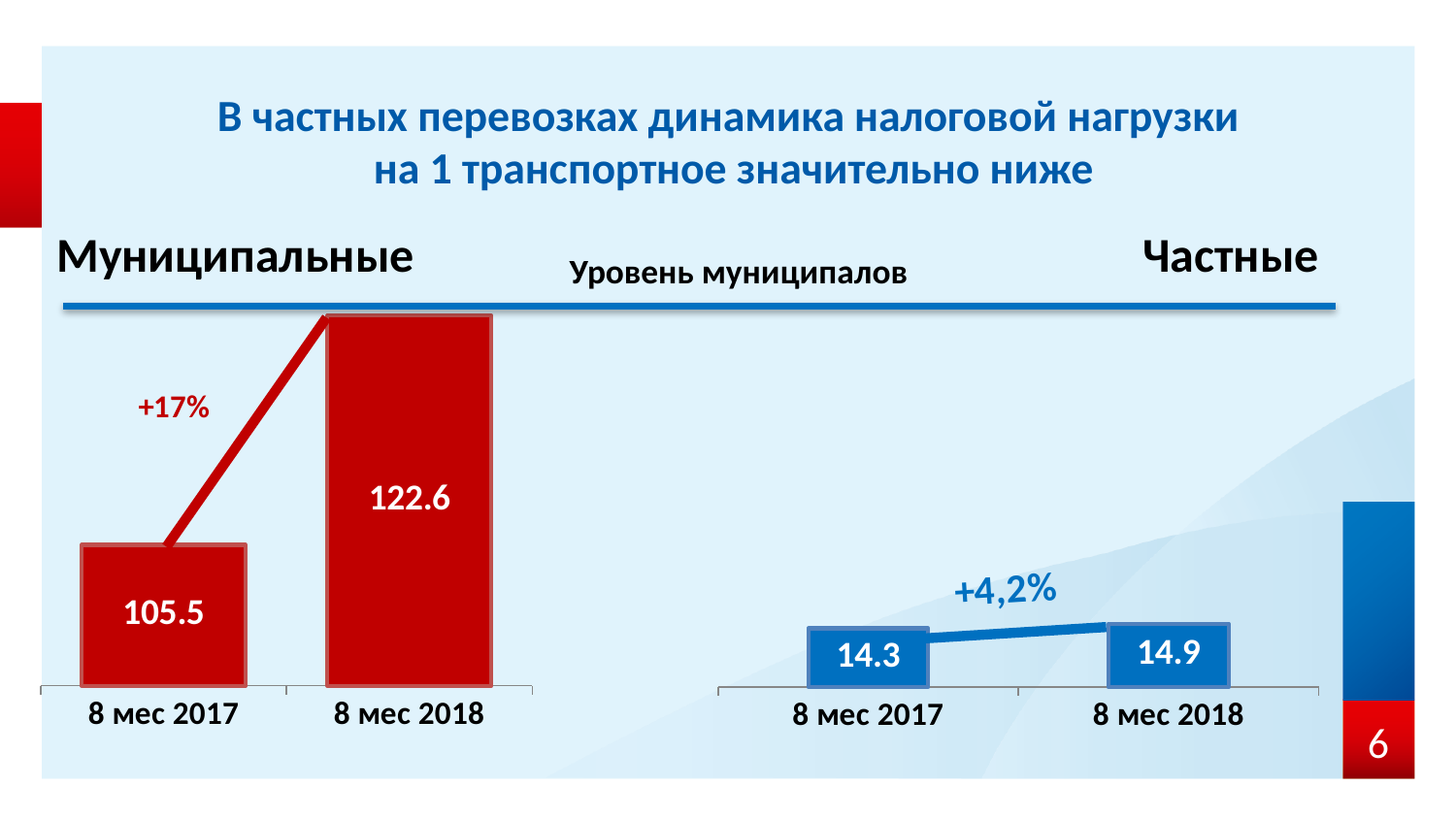
In the Частные chart, which period has the lower value? 8 мес 2017 How many categories are shown in the Частные chart? 2 In the Муниципальные chart, what is the value for 8 мес 2018? 122.6 What type of chart is the Муниципальные chart? bar chart In the Частные chart, what is the value for 8 мес 2018? 14.9 In the Муниципальные chart, which period has the higher value? 8 мес 2018 What percentage change is annotated on the Частные chart? +4,2% In the Муниципальные chart, what is the difference between the 8 мес 2018 and 8 мес 2017 values? 17.1 In the Частные chart, what is the difference between the 8 мес 2018 and 8 мес 2017 values? 0.6 In the Муниципальные chart, what is the value for 8 мес 2017? 105.5 Is the 8 мес 2018 value in the Муниципальные chart larger or smaller than the 8 мес 2018 value in the Частные chart? larger In the Частные chart, what is the value for 8 мес 2017? 14.3